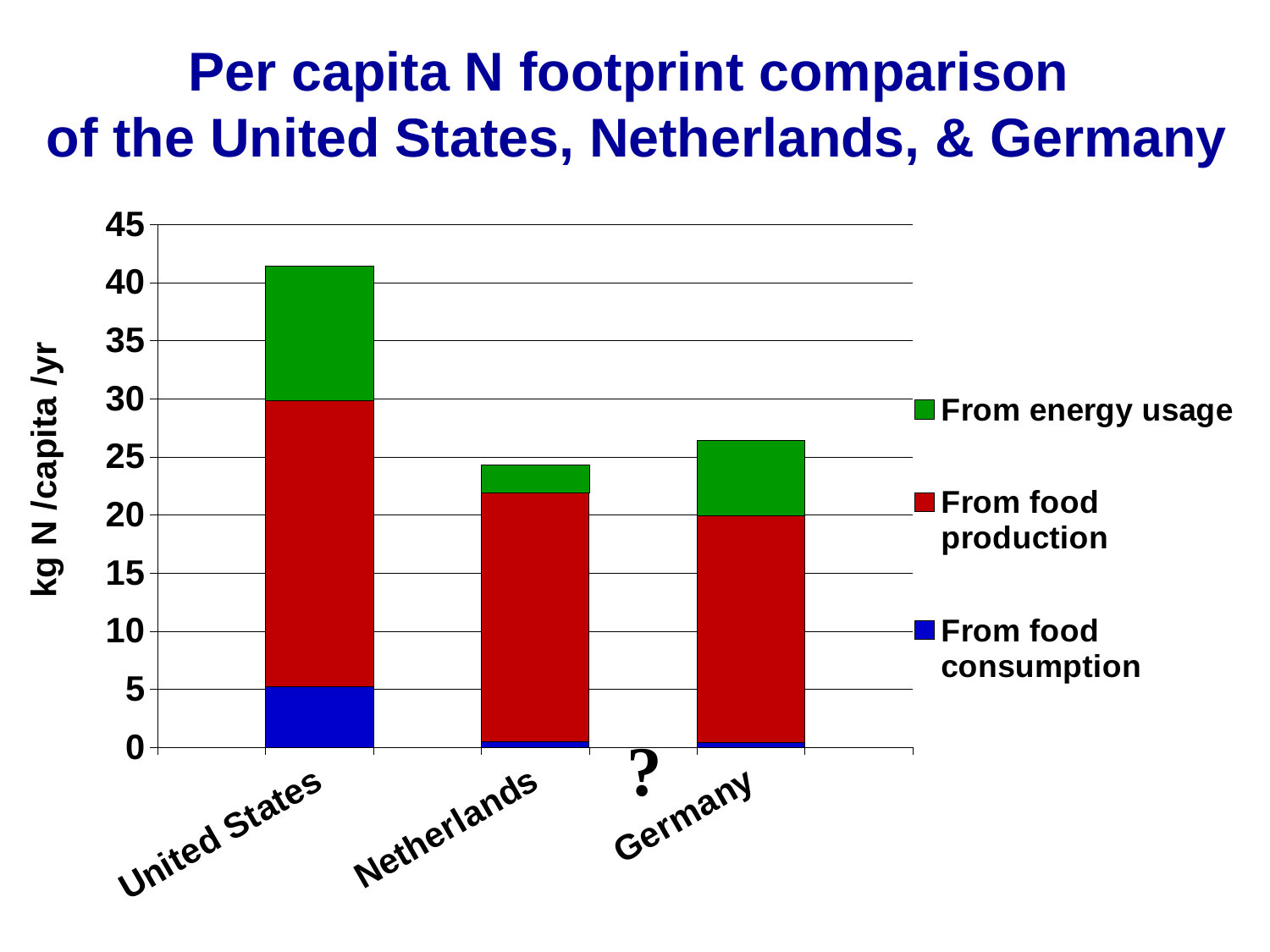
How many series does the chart's legend list? 3 Which has the larger total per capita N footprint, the United States or Germany? United States Is the total value for the Netherlands greater or less than 30? less How many countries are shown on the x axis of the chart? 3 What is the label on the y axis of the chart? kg N /capita /yr Is the total value for Germany greater or less than 30? less What kind of chart is shown on the slide? stacked bar chart Which country has the highest total per capita N footprint? United States Which colour represents 'From energy usage' in the chart's legend? green Is the total value for the United States greater or less than 40? greater Which country has the lowest total per capita N footprint? Netherlands Which has the larger total per capita N footprint, Germany or the Netherlands? Germany